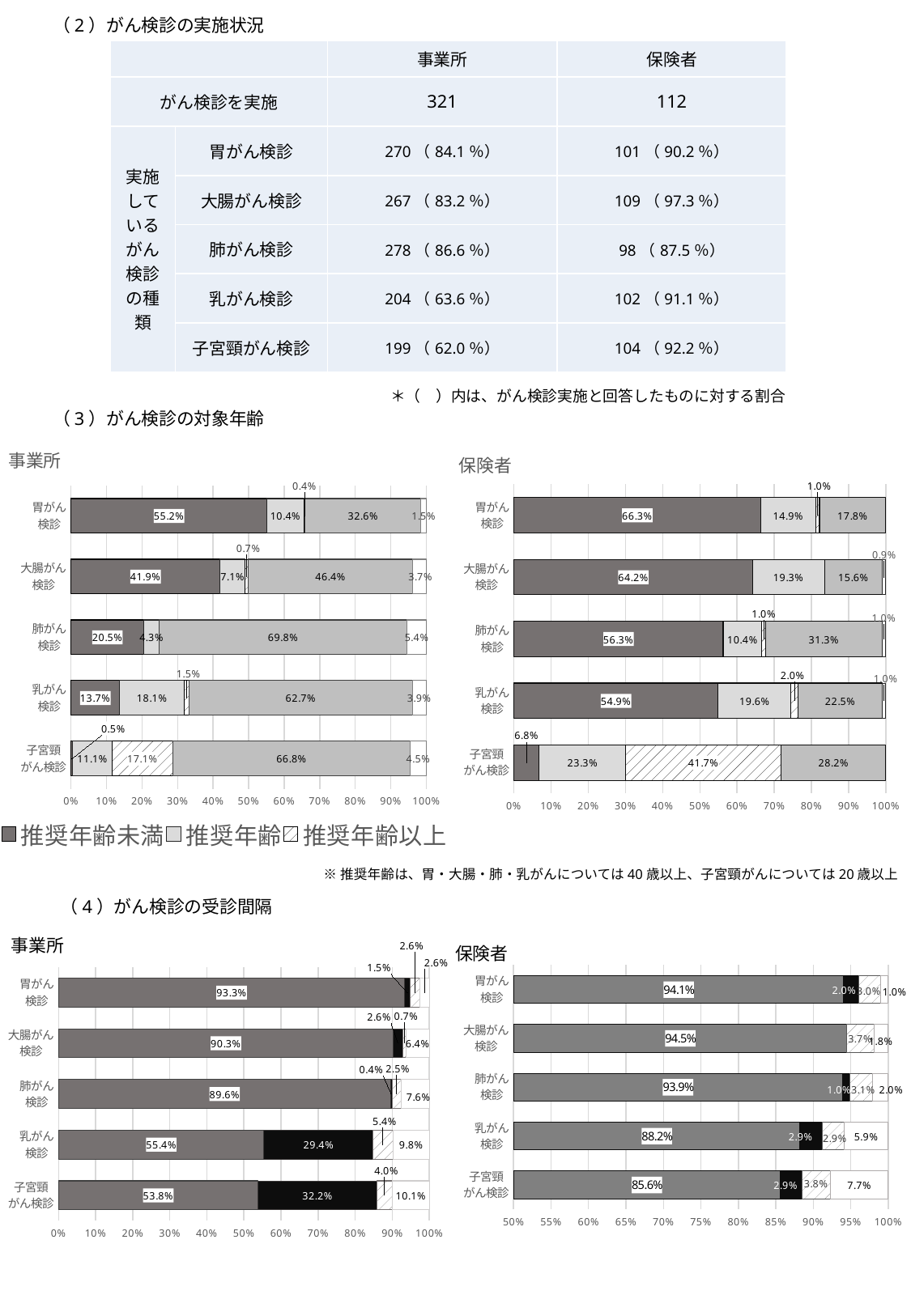
In the (3) がん検診の対象年齢 事業所 chart, which category has the highest 推奨年齢未満 value? 胃がん検診 In the (3) がん検診の対象年齢 保険者 chart, which category has the lowest 推奨年齢未満 value? 子宮頸がん検診 In the (4) がん検診の受診間隔 事業所 chart, what is the value of the first (largest, grey) segment for 乳がん検診? 55.4% In the (3) がん検診の対象年齢 事業所 chart, how much larger is the 推奨年齢未満 value for 胃がん検診 than for 大腸がん検診? 13.3 percentage points In the (4) がん検診の受診間隔 事業所 chart, which category has the lowest value for the first (grey) segment? 子宮頸がん検診 In the (4) がん検診の受診間隔 保険者 chart, is the first (grey) segment for 乳がん検診 greater or less than 90%? less In the (3) がん検診の対象年齢 保険者 chart, which is larger: the 推奨年齢 value for 胃がん検診 or for 大腸がん検診? 大腸がん検診 What kind of chart is the (4) がん検診の受診間隔 事業所 chart? Stacked bar chart In the (3) がん検診の対象年齢 保険者 chart, what is the 推奨年齢未満 value for 子宮頸がん検診? 6.8% In the (3) がん検診の対象年齢 事業所 chart, what is the 推奨年齢未満 value for 胃がん検診? 55.2% How many series does the legend below the (3) がん検診の対象年齢 charts list? 3 How many categories are shown in the (3) がん検診の対象年齢 事業所 chart? 5